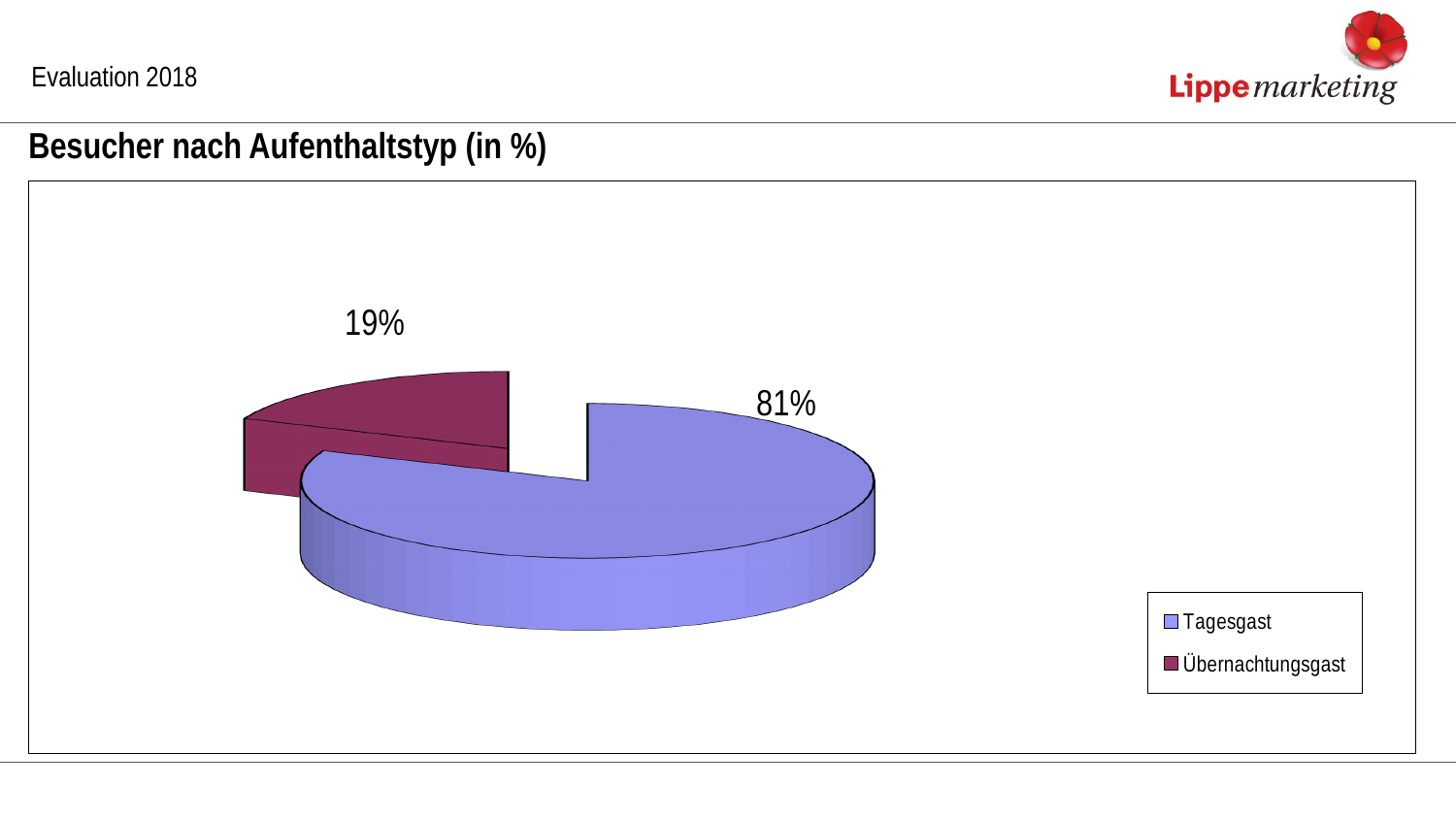
What kind of chart is shown on the slide? Pie chart What is the total of the two slices shown? 100% What share of visitors are Übernachtungsgast? 19% How many entries does the legend list? 2 What share of visitors are Tagesgast? 81% Which category has the smallest slice of the pie? Übernachtungsgast What is the difference in percentage points between Tagesgast and Übernachtungsgast? 62 Which is larger, the share for Tagesgast or for Übernachtungsgast? Tagesgast What is the title of the chart? Besucher nach Aufenthaltstyp (in %) What colour is the Übernachtungsgast slice? Dark red Which category has the largest slice of the pie? Tagesgast How many categories does the pie chart show? 2